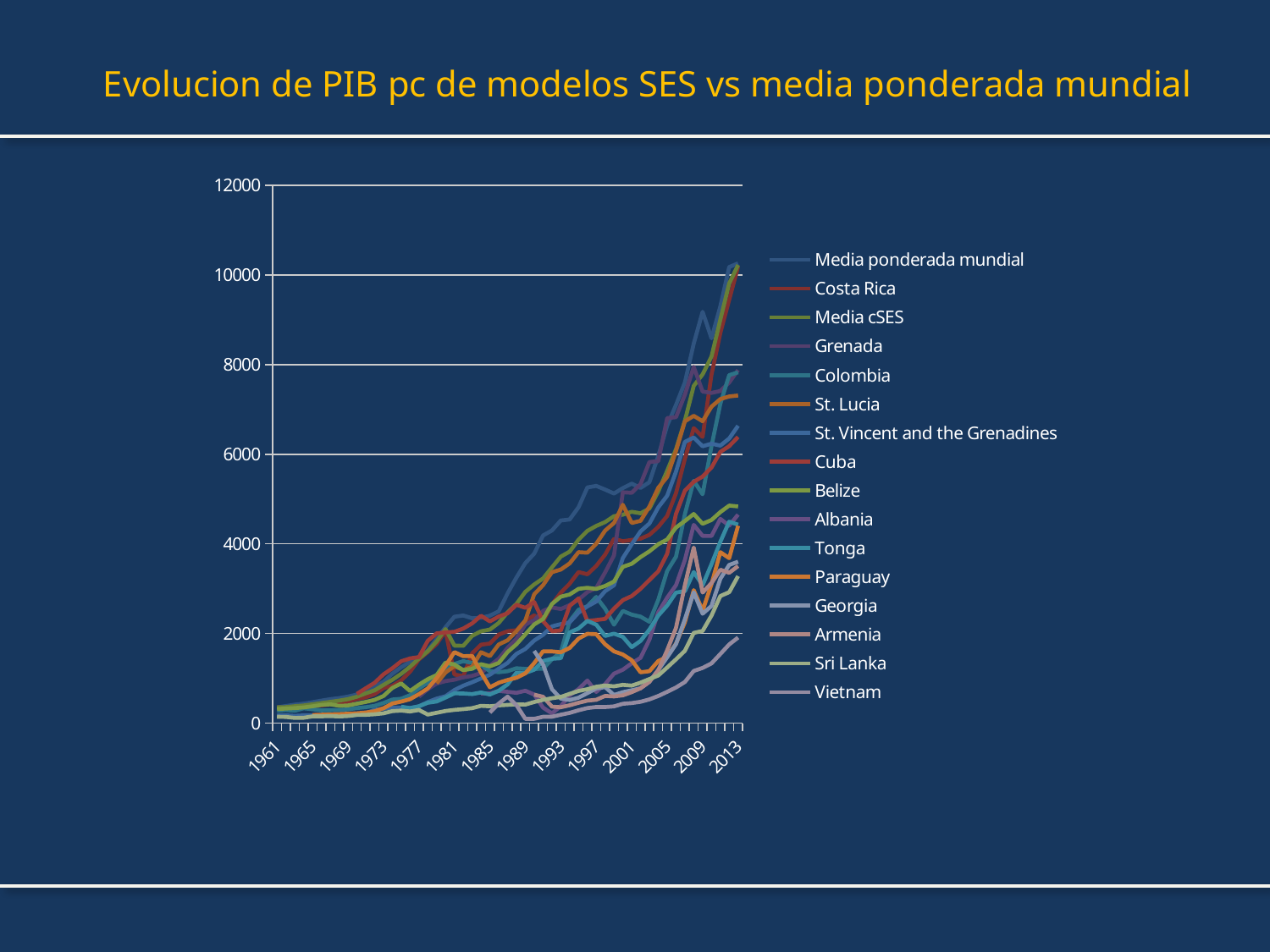
What is the highest value shown on the y axis? 12000 Is the highest value plotted in 2013 greater or less than 8000? greater What kind of chart is shown on the slide? line chart What is the title of the chart? Evolucion de PIB pc de modelos SES vs media ponderada mundial Do the plotted values generally rise or fall from 1961 to 2013? rise Is the lowest value plotted in 2013 greater or less than 4000? less Is the value for Media ponderada mundial in 2013 greater or less than 6000? greater How many series does the legend list? 16 What is the first year shown on the x axis? 1961 Which series is listed first in the legend? Media ponderada mundial What is the last year shown on the x axis? 2013